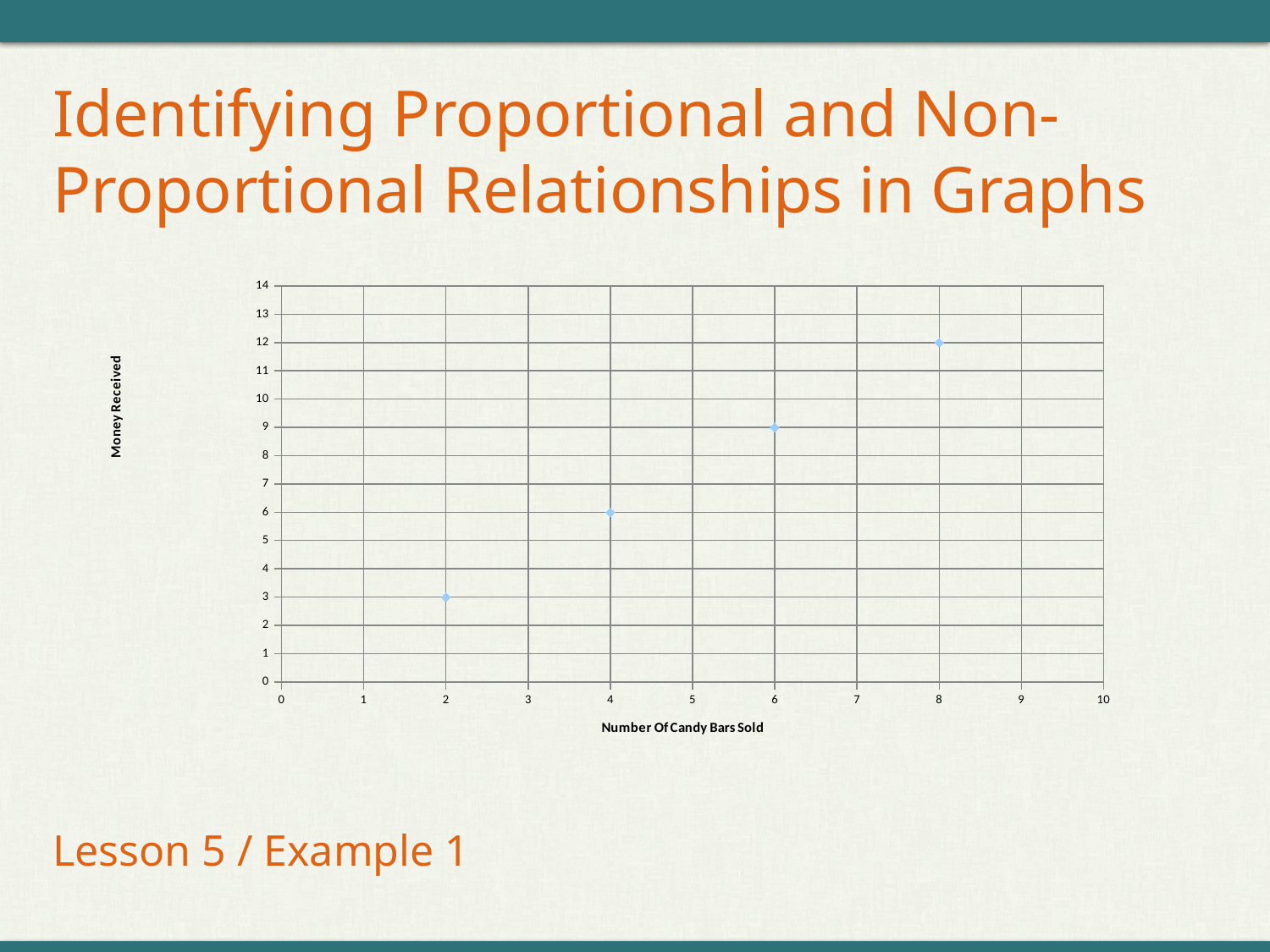
What is the difference in Money Received between 8 candy bars sold and 2 candy bars sold? 9 Does the Money Received rise or fall as the Number Of Candy Bars Sold increases? rise What is the Money Received when the Number Of Candy Bars Sold is 2? 3 What is the Money Received when the Number Of Candy Bars Sold is 8? 12 Which has a higher Money Received: 4 candy bars sold or 6 candy bars sold? 6 candy bars sold What is the Money Received when the Number Of Candy Bars Sold is 4? 6 At which Number Of Candy Bars Sold is the Money Received highest? 8 How many data points are plotted on the chart? 4 What is the label of the vertical axis? Money Received What type of chart is shown on the slide? scatter plot What is the Money Received when the Number Of Candy Bars Sold is 6? 9 At which Number Of Candy Bars Sold is the Money Received lowest? 2